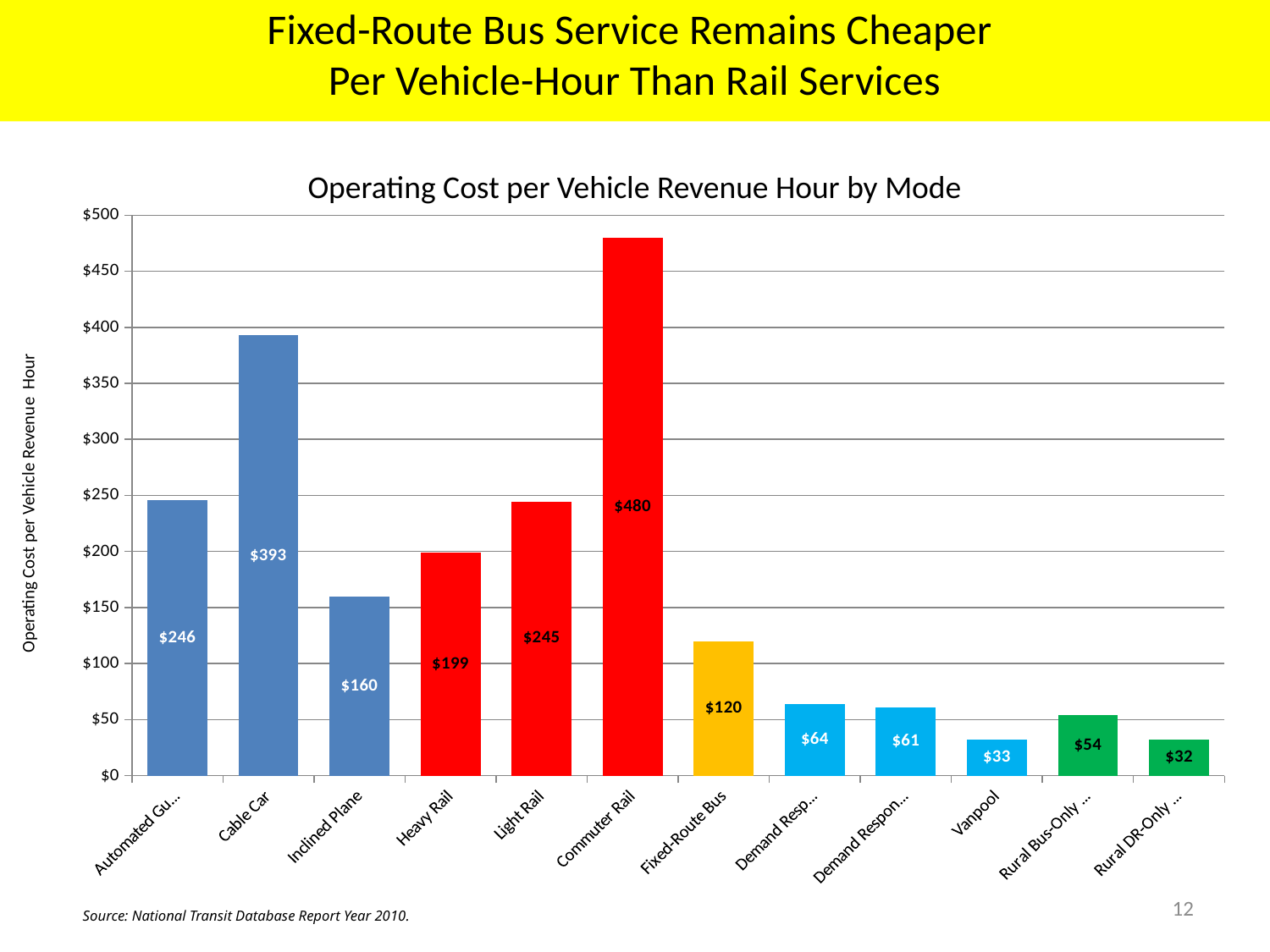
What is the difference between the Commuter Rail value and the Fixed-Route Bus value? $360 Is the value for Cable Car greater or less than $350? greater What is the value shown for Inclined Plane? $160 What is the value shown for Fixed-Route Bus? $120 What is the difference between the Cable Car value and the Light Rail value? $148 How many bars are plotted in the chart? 12 Which is larger, the value for Heavy Rail or the value for Light Rail? Light Rail What is the operating cost per vehicle revenue hour for Commuter Rail? $480 Which mode has the highest operating cost per vehicle revenue hour? Commuter Rail What type of chart is shown on the slide? Bar chart What is the value shown for Vanpool? $33 What is the value shown for Cable Car? $393